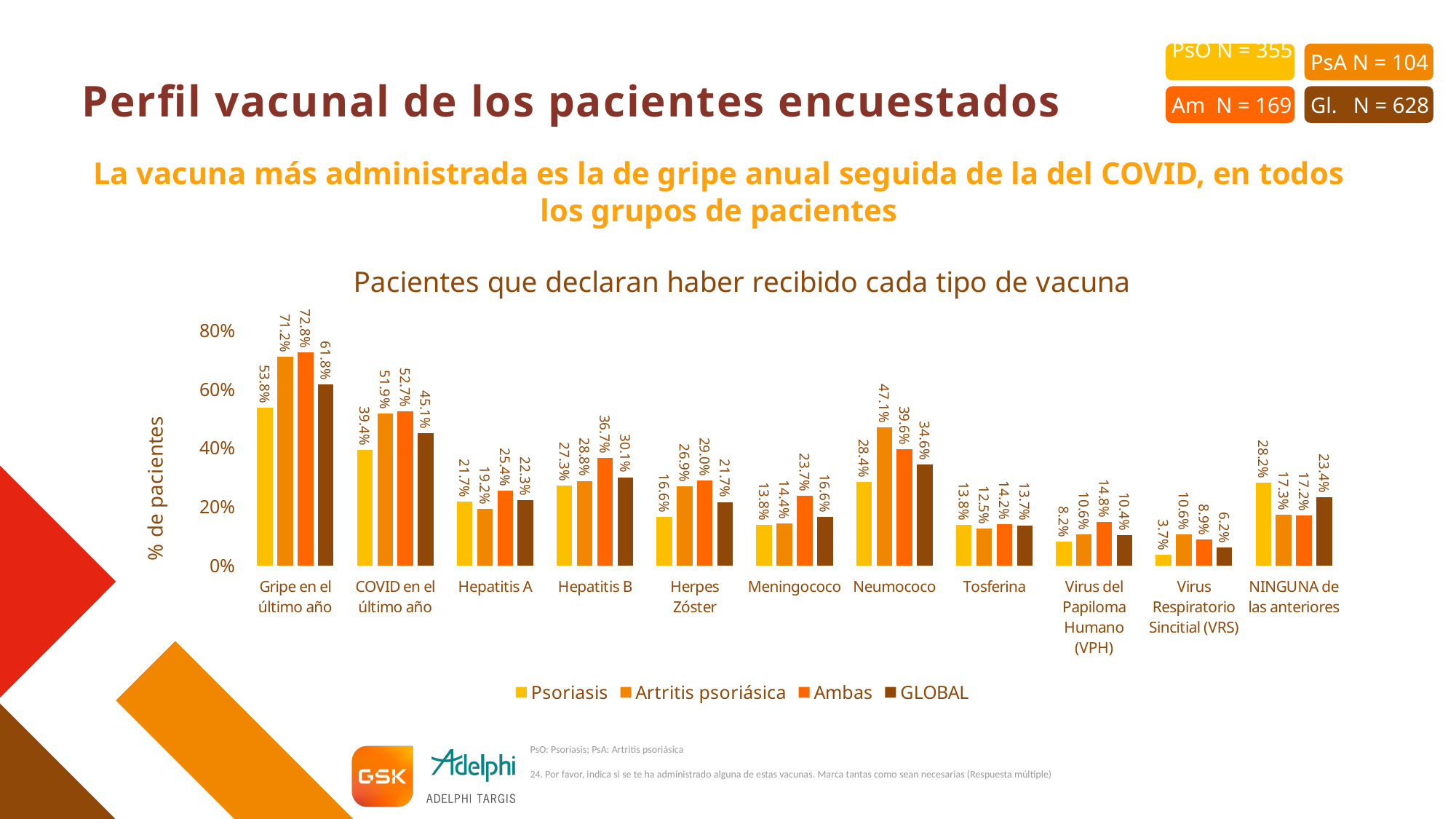
What is the difference between the Artritis psoriásica and Psoriasis values for Neumococo? 18.7% What percentage of the Psoriasis group reported receiving the COVID vaccine in the last year? 39.4% Which category has the lowest Psoriasis value? Virus Respiratorio Sincitial (VRS) Is the Artritis psoriásica value for Neumococo greater or less than 40%? greater How many series does the legend list? 4 What is the title of the chart? Pacientes que declaran haber recibido cada tipo de vacuna How many vaccine categories are shown on the x axis? 11 What is the Ambas value for Hepatitis B? 36.7% What is the GLOBAL value for 'Gripe en el último año'? 61.8% For Herpes Zóster, which is larger: the Psoriasis value or the Ambas value? Ambas Which category has the highest GLOBAL value? Gripe en el último año What kind of chart is shown on the slide? Bar chart